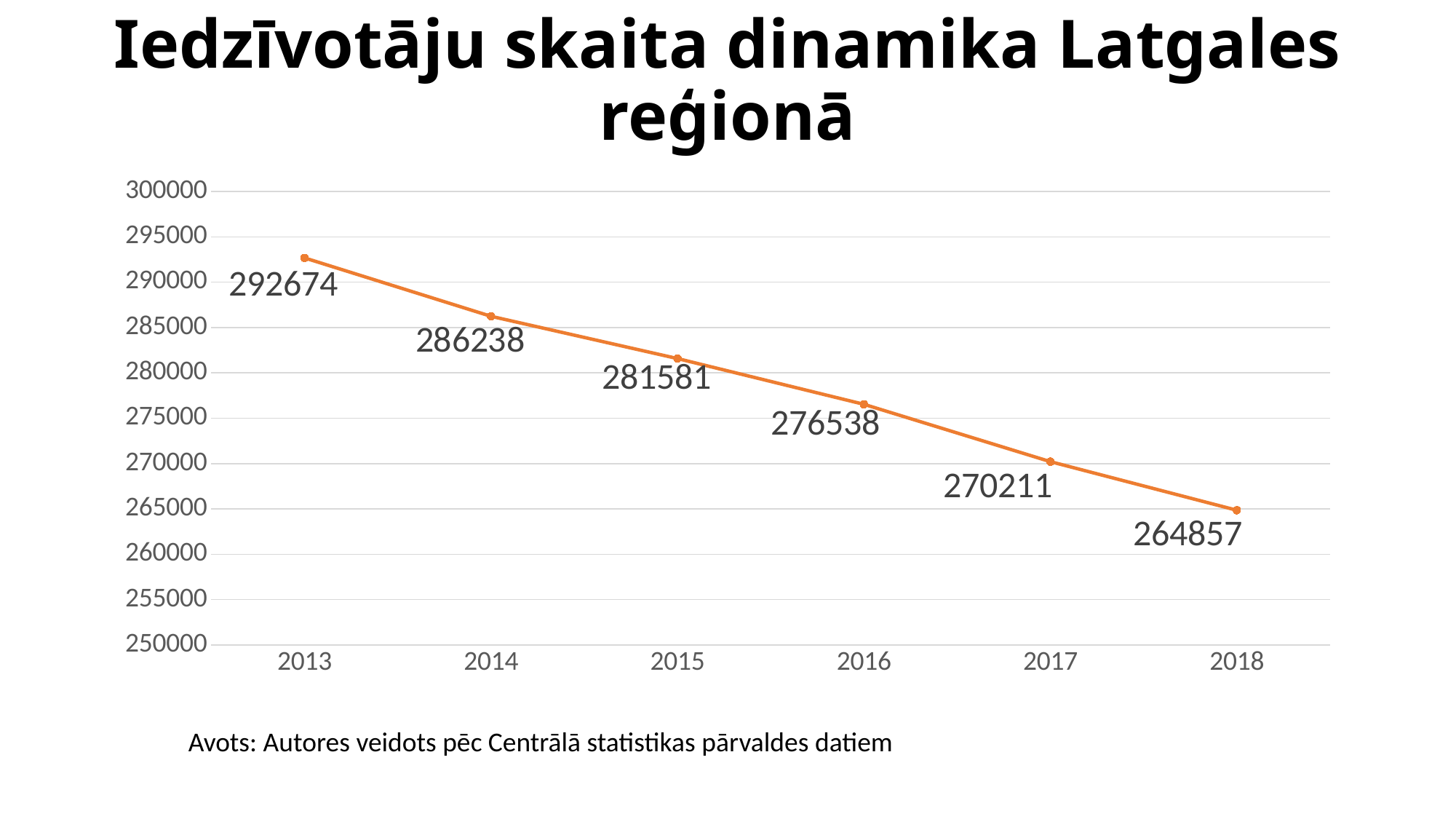
What is the difference between the 2013 value and the 2018 value? 27817 How many years are plotted on the chart? 6 What is the population value shown for 2018? 264857 Which year has the highest population value? 2013 What is the population value shown for 2016? 276538 Which is larger, the value for 2015 or the value for 2017? 2015 Which year has the lowest population value? 2018 What is the difference between the 2014 value and the 2015 value? 4657 What kind of chart is shown on the slide? line chart Do the values rise or fall from 2013 to 2018? fall What is the population value shown for 2013? 292674 Is the value for 2017 greater or less than 275000? less